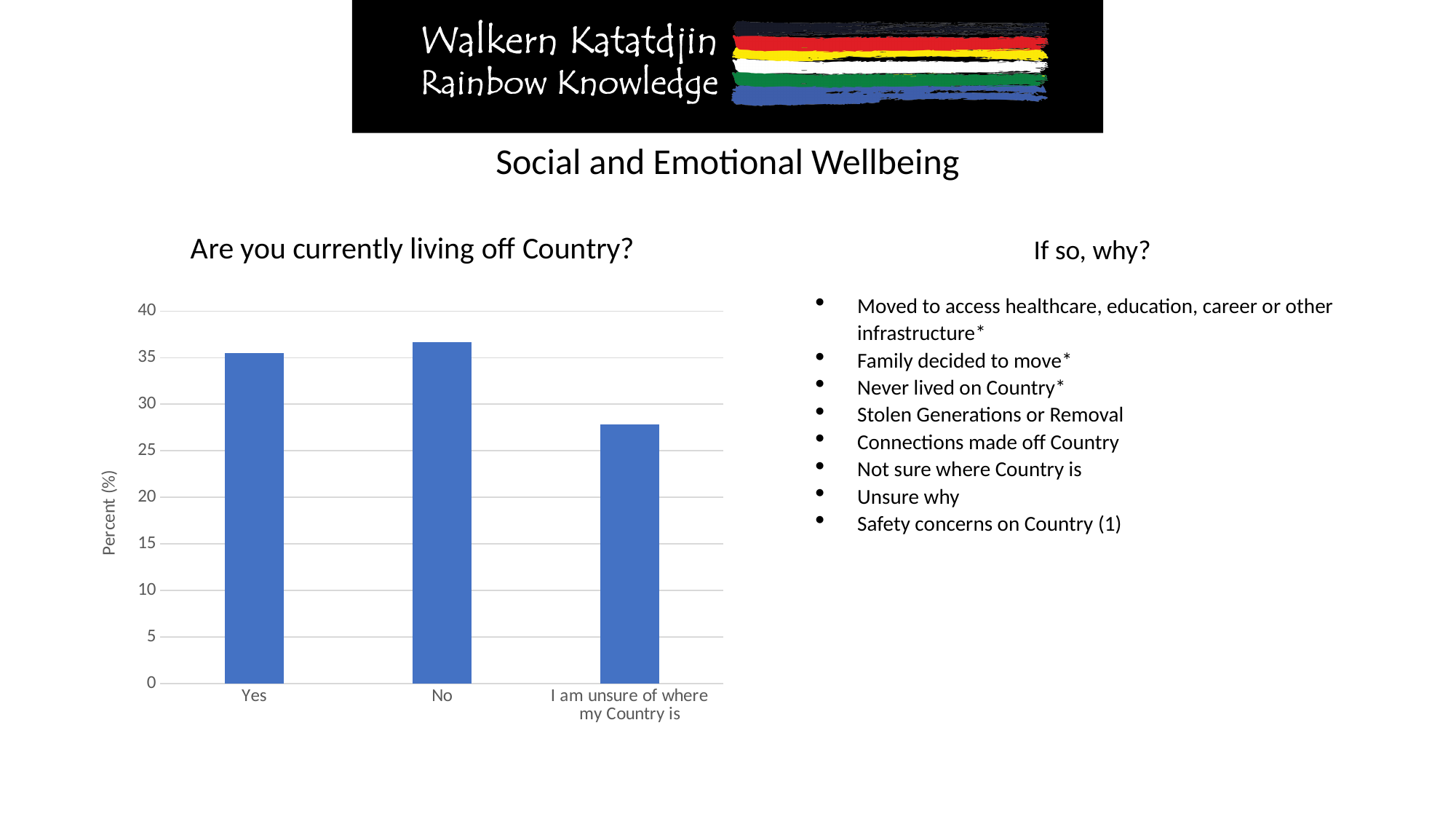
Which is larger, the value for No or the value for 'I am unsure of where my Country is'? No Which category has the lowest value in the chart? I am unsure of where my Country is Is the value for No greater or less than 30? greater Is the value for 'I am unsure of where my Country is' greater or less than 25? greater Is the value for 'I am unsure of where my Country is' greater or less than 30? less How many categories are shown on the x axis of the chart? 3 What is the title of the chart? Are you currently living off Country? Which is larger, the value for Yes or the value for 'I am unsure of where my Country is'? Yes What kind of chart is shown on the slide? bar chart What is the label on the vertical axis of the chart? Percent (%)